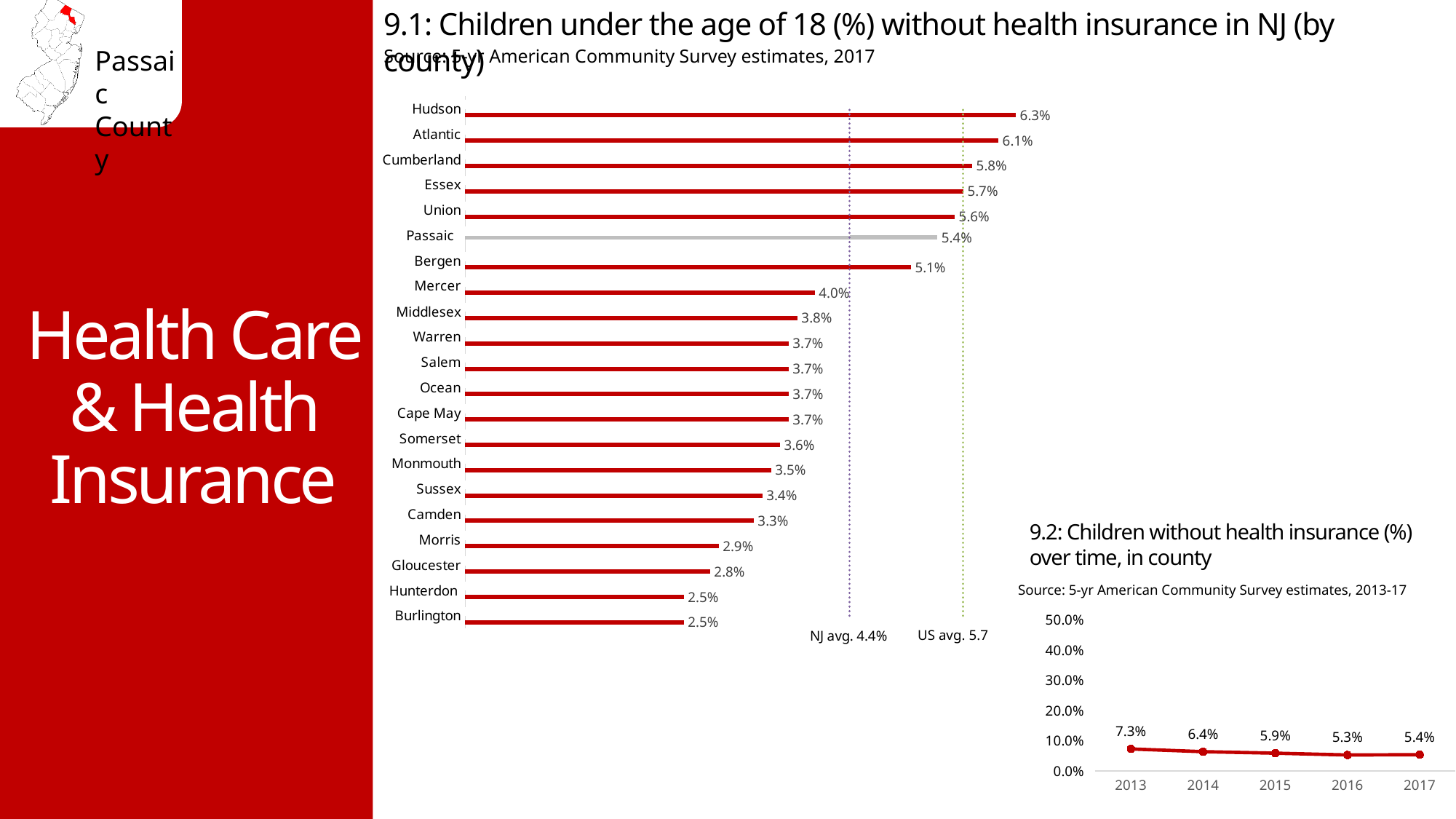
In chart 9.1, what is the difference between the values for Hudson and Passaic? 0.9% What kind of chart is chart 9.1? Bar chart In chart 9.1, what is the value for Passaic? 5.4% In chart 9.2, how many years are plotted? 5 In chart 9.1, what is the NJ average shown by the dotted reference line? 4.4% In chart 9.1, how many counties are shown? 21 In chart 9.2, what is the value for 2013? 7.3% In chart 9.2, what is the difference between the values for 2013 and 2017? 1.9% In chart 9.1, what is the value for Bergen? 5.1% In chart 9.1, which is larger, the value for Mercer or the value for Camden? Mercer In chart 9.1, which county has the highest percentage of children without health insurance? Hudson In chart 9.2, which year has the lowest value? 2016